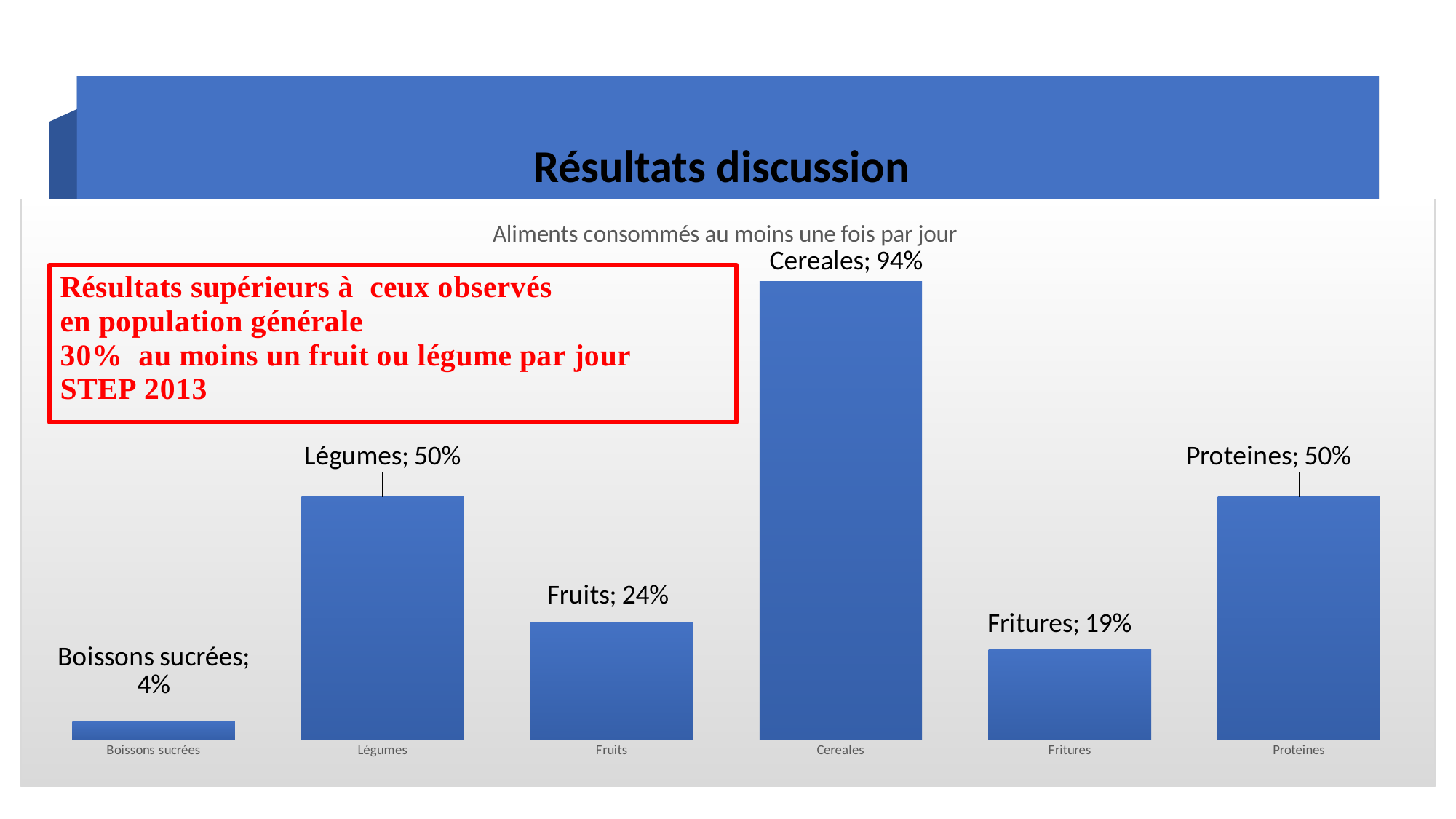
What is the difference between the values for Fruits and Fritures? 5% What is the title of the chart? Aliments consommés au moins une fois par jour Which is larger, the value for Fruits or the value for Fritures? Fruits What is the value for Fruits? 24% How many categories are shown in the chart? 6 What is the value for Fritures? 19% Which category has the highest value? Cereales What kind of chart is shown on the slide? Bar chart Which category has the lowest value? Boissons sucrées What is the difference between the values for Cereales and Légumes? 44% What is the value for Boissons sucrées? 4% What is the value for Cereales? 94%